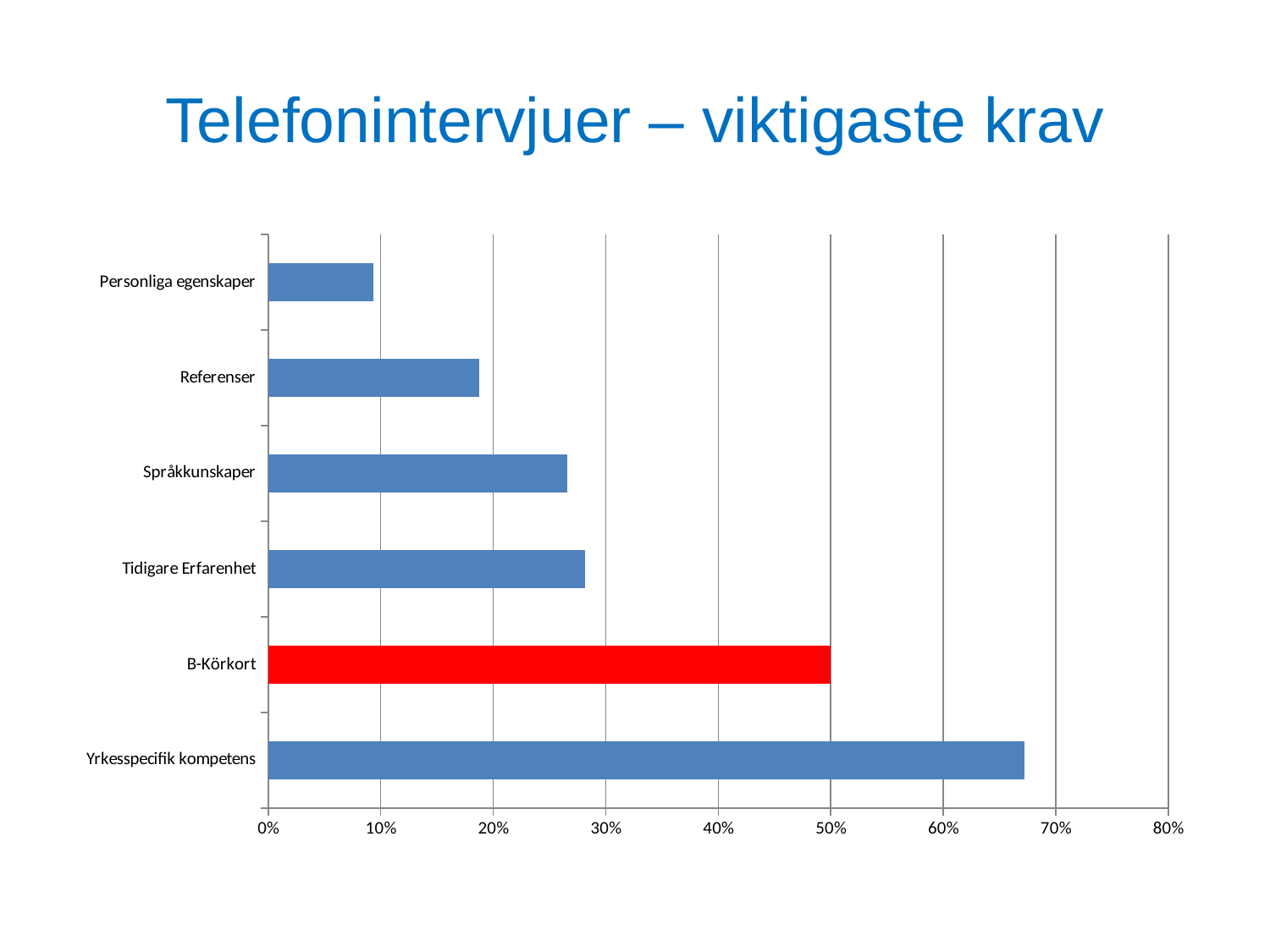
Which bar is coloured red in the chart? B-Körkort Is the value for Referenser greater or less than 20%? less Which category has the highest value? Yrkesspecifik kompetens Which is larger, the value for Referenser or the value for B-Körkort? B-Körkort What is the value for B-Körkort? 50% What is the title of the slide? Telefonintervjuer – viktigaste krav What kind of chart is shown on the slide? bar chart How many categories are shown in the chart? 6 Which category has the lowest value? Personliga egenskaper Is the value for Tidigare Erfarenhet greater or less than 30%? less Is the value for Personliga egenskaper greater or less than 10%? less